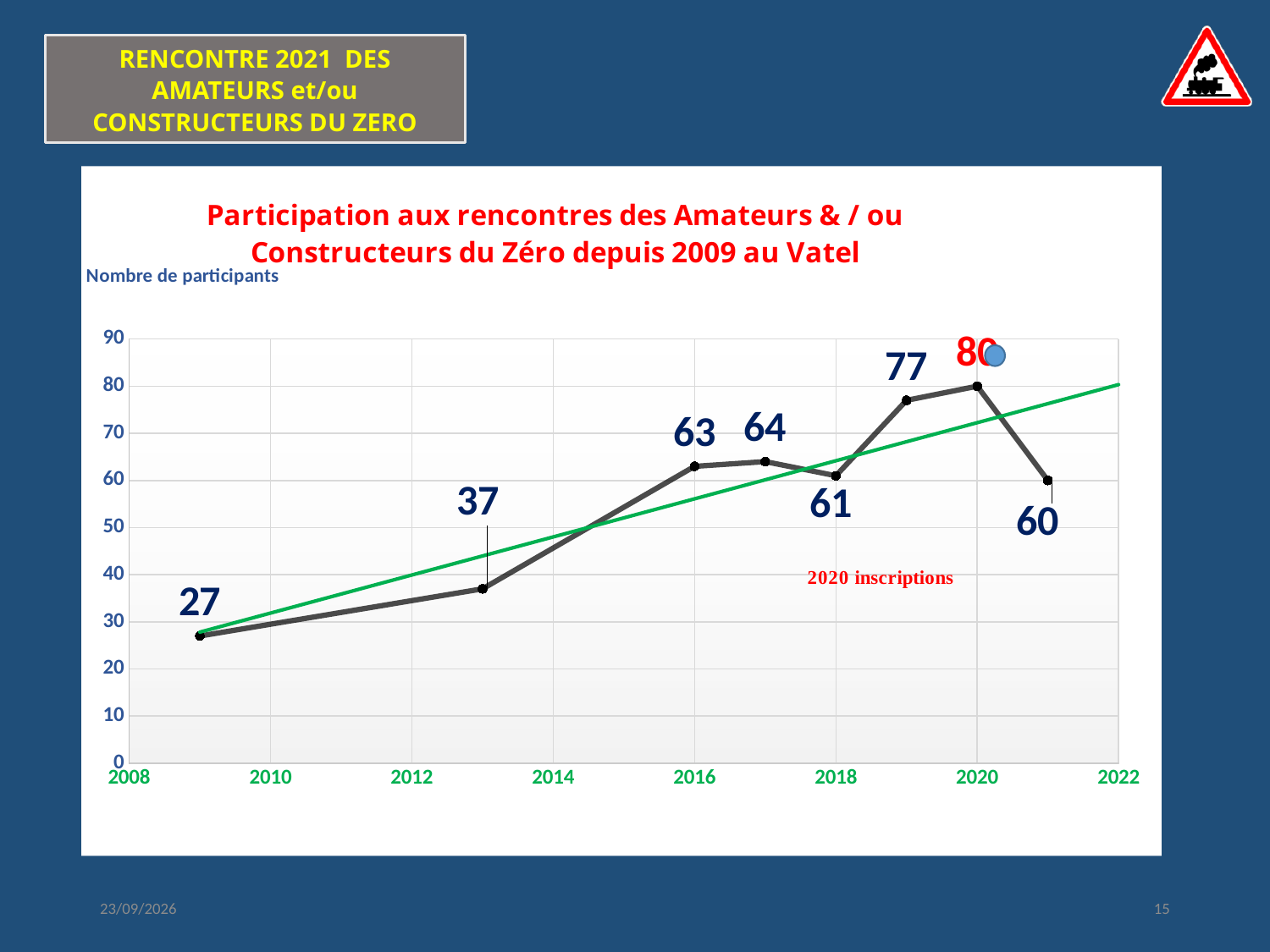
What value is labelled for 2020 (inscriptions)? 80 Which year has the lowest value on the chart? 2009 What is the number of participants in 2013? 37 What is the difference between the values for 2019 and 2021? 17 What is the number of participants in 2021? 60 How many data points are plotted on the dark line? 8 Which year has the highest value on the chart? 2020 What is the number of participants in 2019? 77 What is the label of the vertical axis? Nombre de participants What type of chart is shown on the slide? line chart Which is larger, the value for 2016 or the value for 2018? 2016 What is the number of participants in 2009? 27